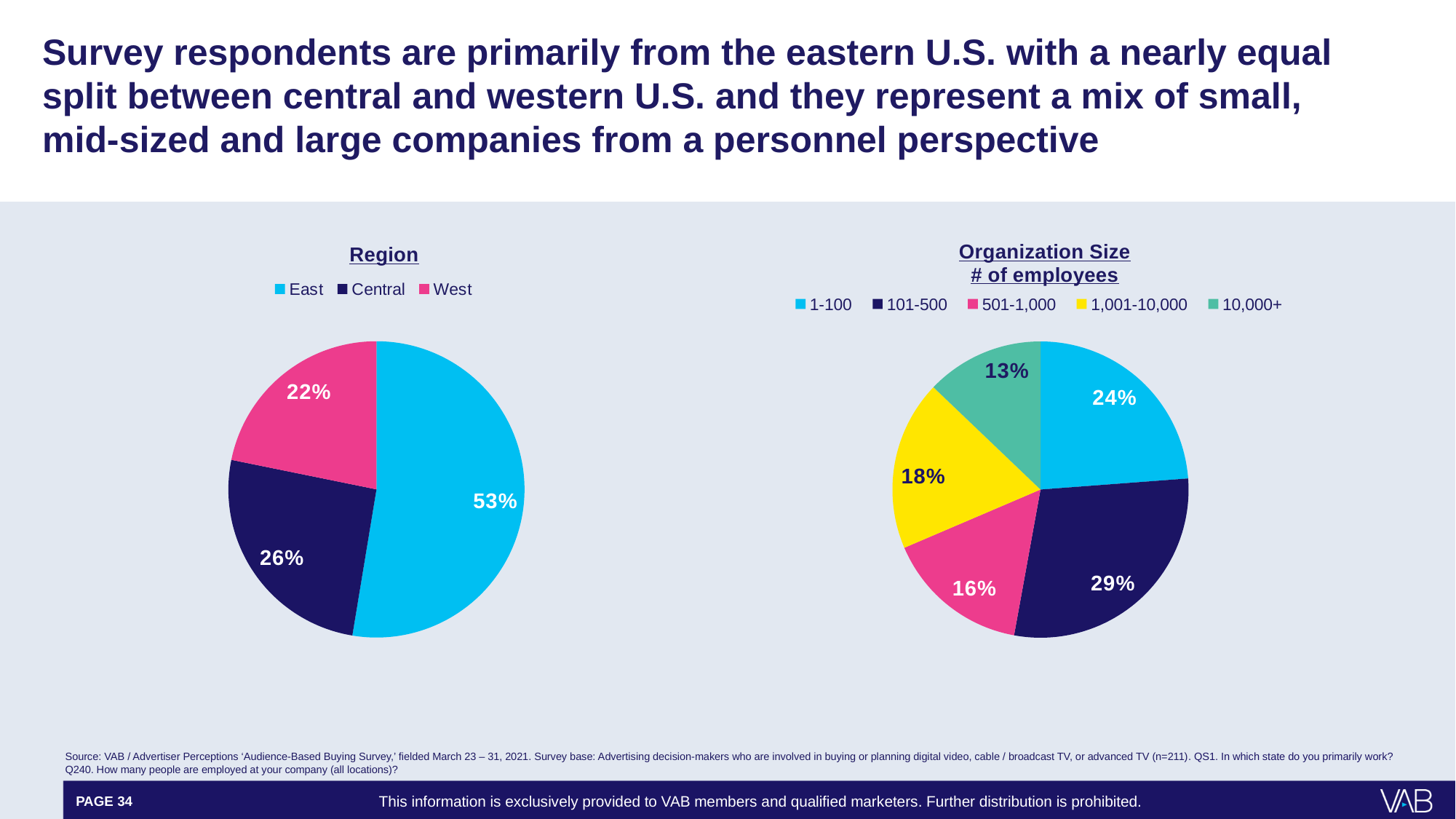
In the Organization Size chart, which employee-size category has the largest share? 101-500 In the Organization Size chart, what is the difference between the 1-100 and 501-1,000 shares? 8% In the Region chart, what is the difference between the Central and West shares? 4% In the Organization Size chart, what share of respondents are from companies with 101-500 employees? 29% In the Region chart, what share of respondents are from the West? 22% In the Region chart, how many regions are shown? 3 In the Region chart, what share of respondents are from the East? 53% In the Organization Size chart, which is larger: the share for 1-100 employees or for 1,001-10,000 employees? 1-100 How many categories does the legend of the Organization Size chart list? 5 In the Region chart, which region has the smallest share? West What kind of chart is the Region chart? Pie chart In the Organization Size chart, what share of respondents are from companies with 10,000+ employees? 13%